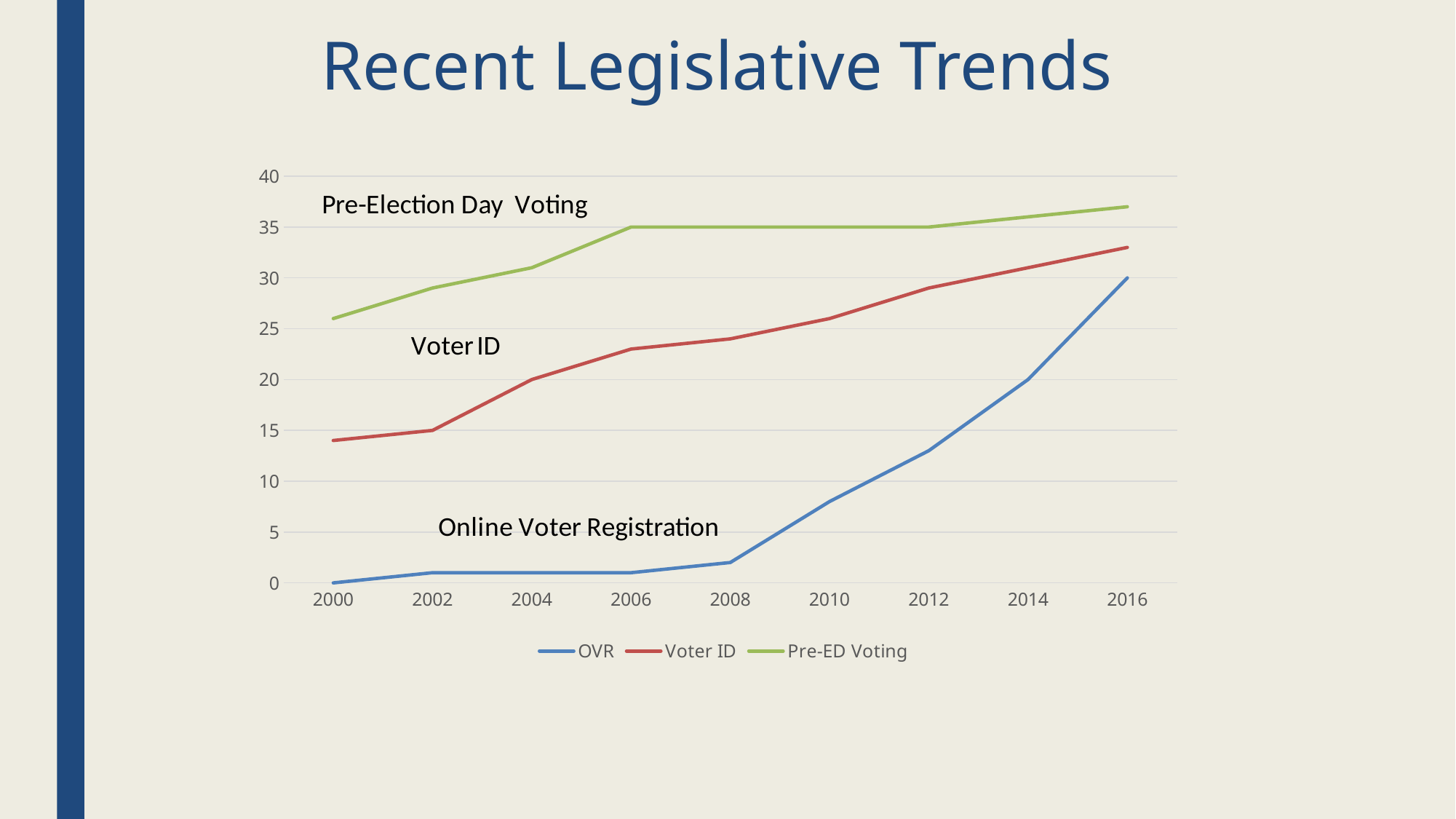
Does the OVR line rise or fall from 2008 to 2016? rise What kind of chart is shown on the slide? line chart What is the value for OVR in 2014? 20 How many series does the legend list? 3 Which series has the lowest value in 2008? OVR Which series has the highest value in 2000? Pre-ED Voting Is the value for Pre-ED Voting in 2016 greater or less than 35? greater What is the value for Pre-ED Voting in 2008? 35 What is the value for Voter ID in 2004? 20 How many years are plotted along the x axis? 9 Is the value for Voter ID in 2000 greater or less than 15? less What is the value for OVR in 2016? 30